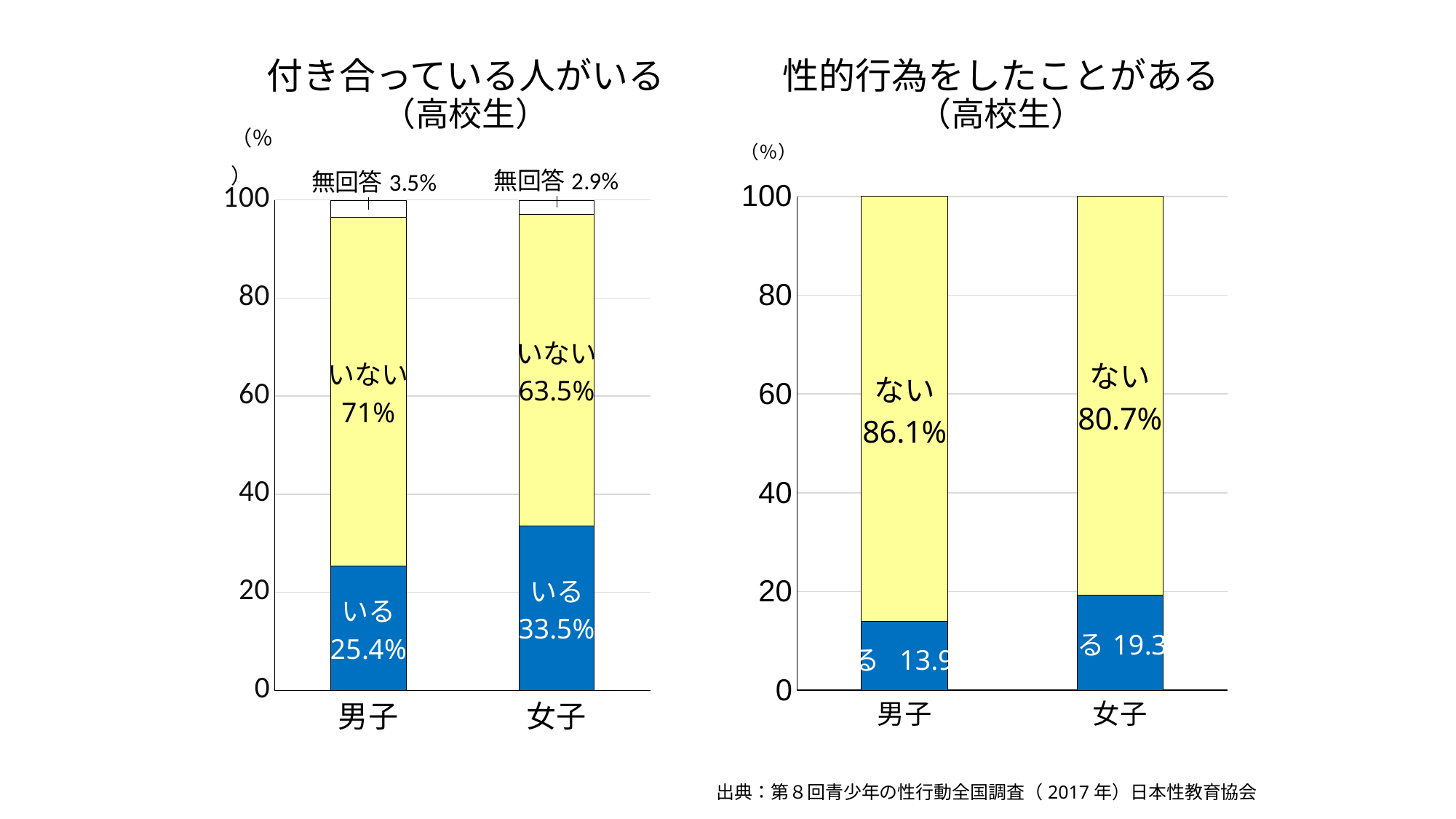
In the left chart (付き合っている人がいる), which group has the higher いる value, 男子 or 女子? 女子 In the left chart (付き合っている人がいる), how many categories are shown on the x axis? 2 In the left chart (付き合っている人がいる), what is the value of いない for 女子? 63.5% In the right chart (性的行為をしたことがある), is the blue ある segment for 女子 greater or less than 20? less In the right chart (性的行為をしたことがある), what is the value of ない for 男子? 86.1% In the left chart (付き合っている人がいる), what is the value of いる for 男子? 25.4% In the left chart (付き合っている人がいる), what is the 無回答 value for 男子? 3.5% In the right chart (性的行為をしたことがある), what is the value of ない for 女子? 80.7% In the right chart (性的行為をしたことがある), what is the difference between the ない values for 男子 and 女子? 5.4% In the left chart (付き合っている人がいる), what colour is the いる segment? Blue What kind of chart is the right chart (性的行為をしたことがある)? Stacked bar chart In the left chart (付き合っている人がいる), what is the difference between the いる values for 女子 and 男子? 8.1%